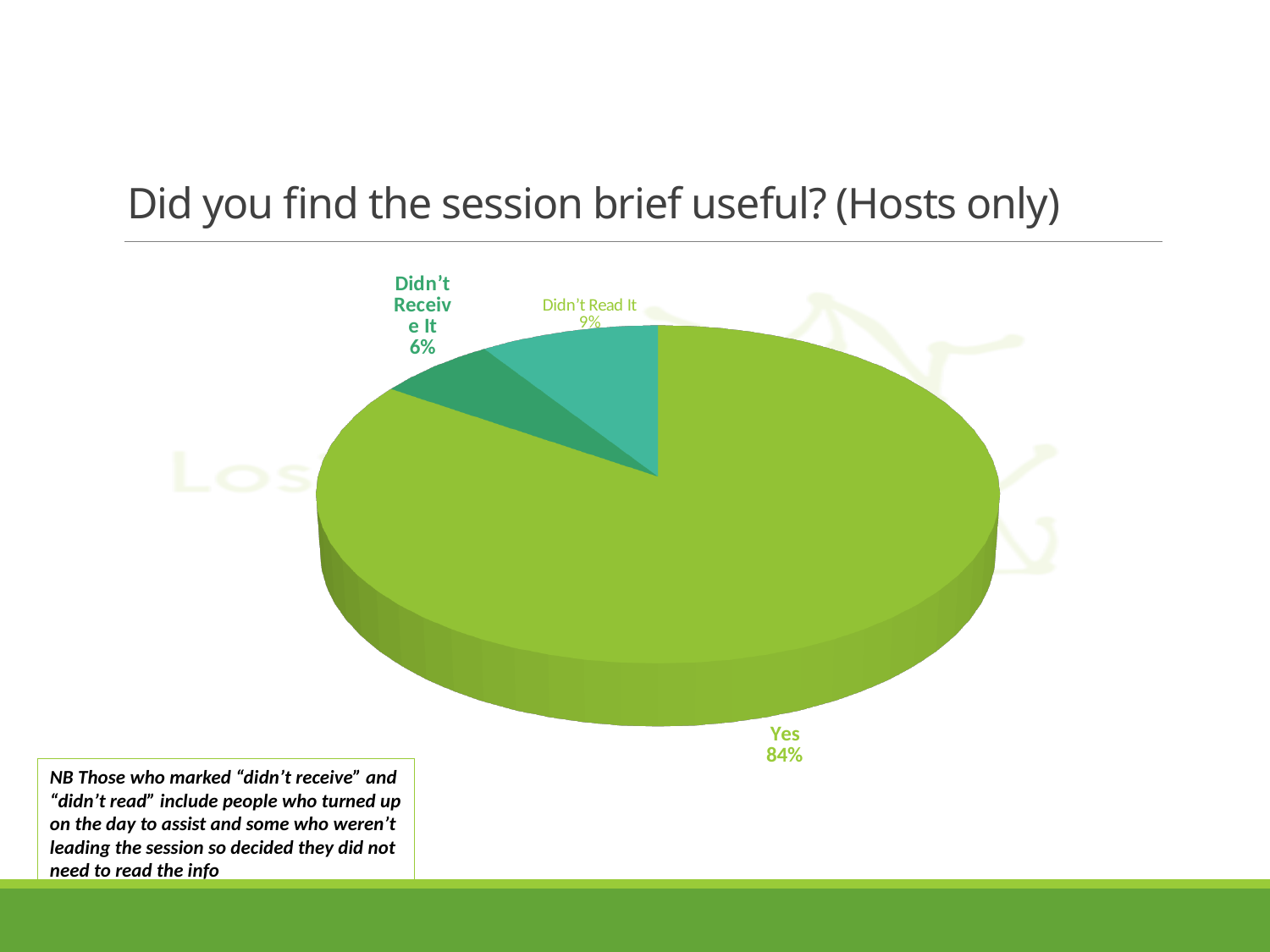
What colour is the "Yes" slice of the pie? Green Which category has the smallest slice of the pie? Didn't Receive It How many slices does the pie chart have? 3 What is the difference in percentage points between the "Didn't Read It" slice and the "Didn't Receive It" slice? 3 What share of the pie does the "Yes" slice represent? 84% Which slice is larger, "Didn't Read It" or "Didn't Receive It"? Didn't Read It Which category has the largest slice of the pie? Yes What share of the pie does the "Didn't Read It" slice represent? 9% What kind of chart is shown on the slide? Pie chart What share of the pie does the "Didn't Receive It" slice represent? 6% What is the difference in percentage points between the "Yes" slice and the "Didn't Read It" slice? 75 What is the title of the chart? Did you find the session brief useful? (Hosts only)